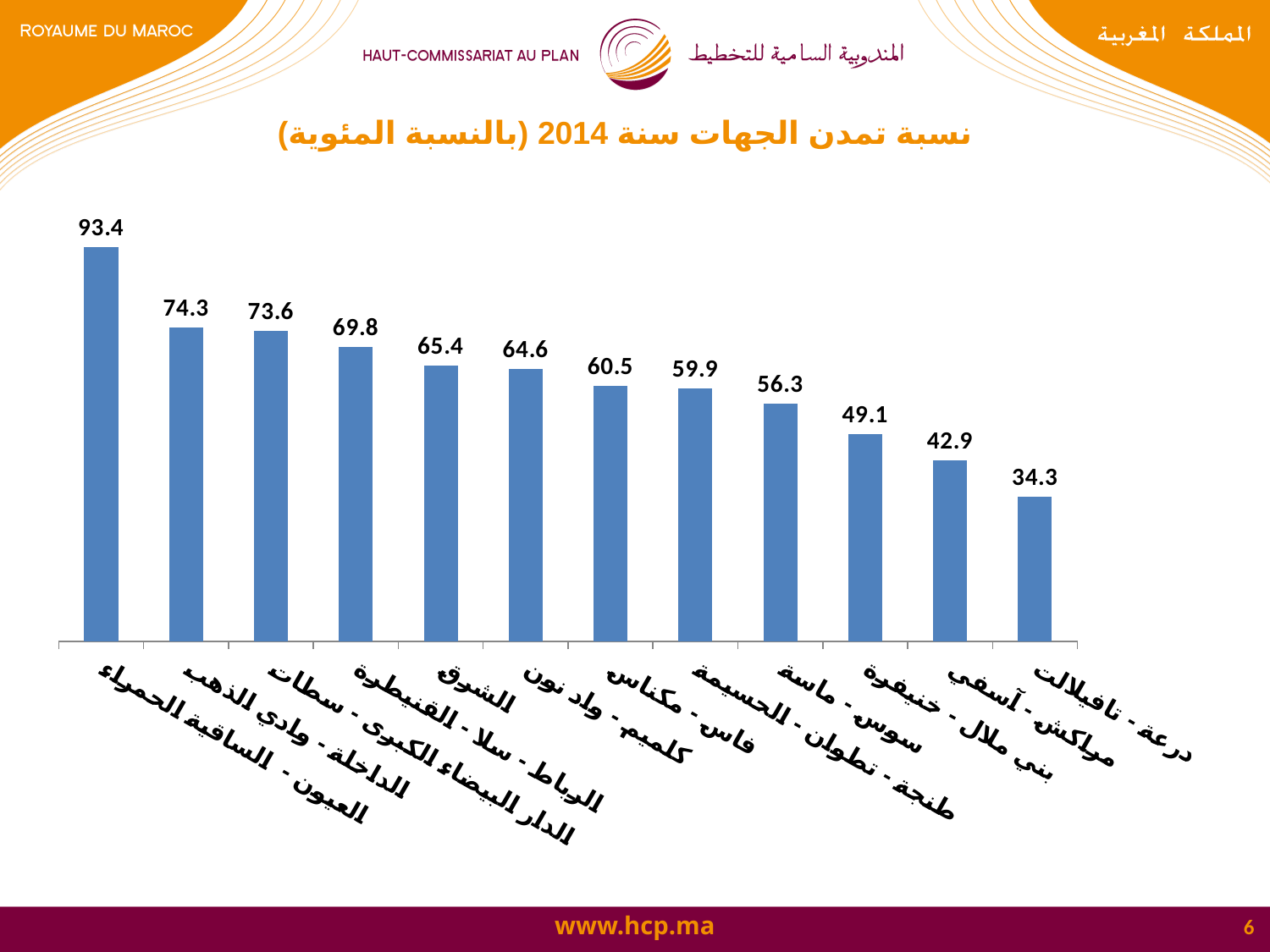
What kind of chart is shown on the slide? Bar chart Which has a higher value, سوس - ماسة or بني ملال - خنيفرة? سوس - ماسة What value is shown for درعة - تافيلالت? 34.3 Do the values rise or fall from left to right along the x axis? Fall What is the difference between the values for العيون - الساقية الحمراء and درعة - تافيلالت? 59.1 Which region has the highest urbanization rate on the chart? العيون - الساقية الحمراء Which region has the lowest urbanization rate on the chart? درعة - تافيلالت How many regions are shown on the chart? 12 What is the value for الرباط - سلا - القنيطرة? 69.8 What value is shown for فاس - مكناس? 60.5 What is the difference between the values for الداخلة - وادي الذهب and الدار البيضاء الكبرى - سطات? 0.7 What is the urbanization rate shown for العيون - الساقية الحمراء? 93.4